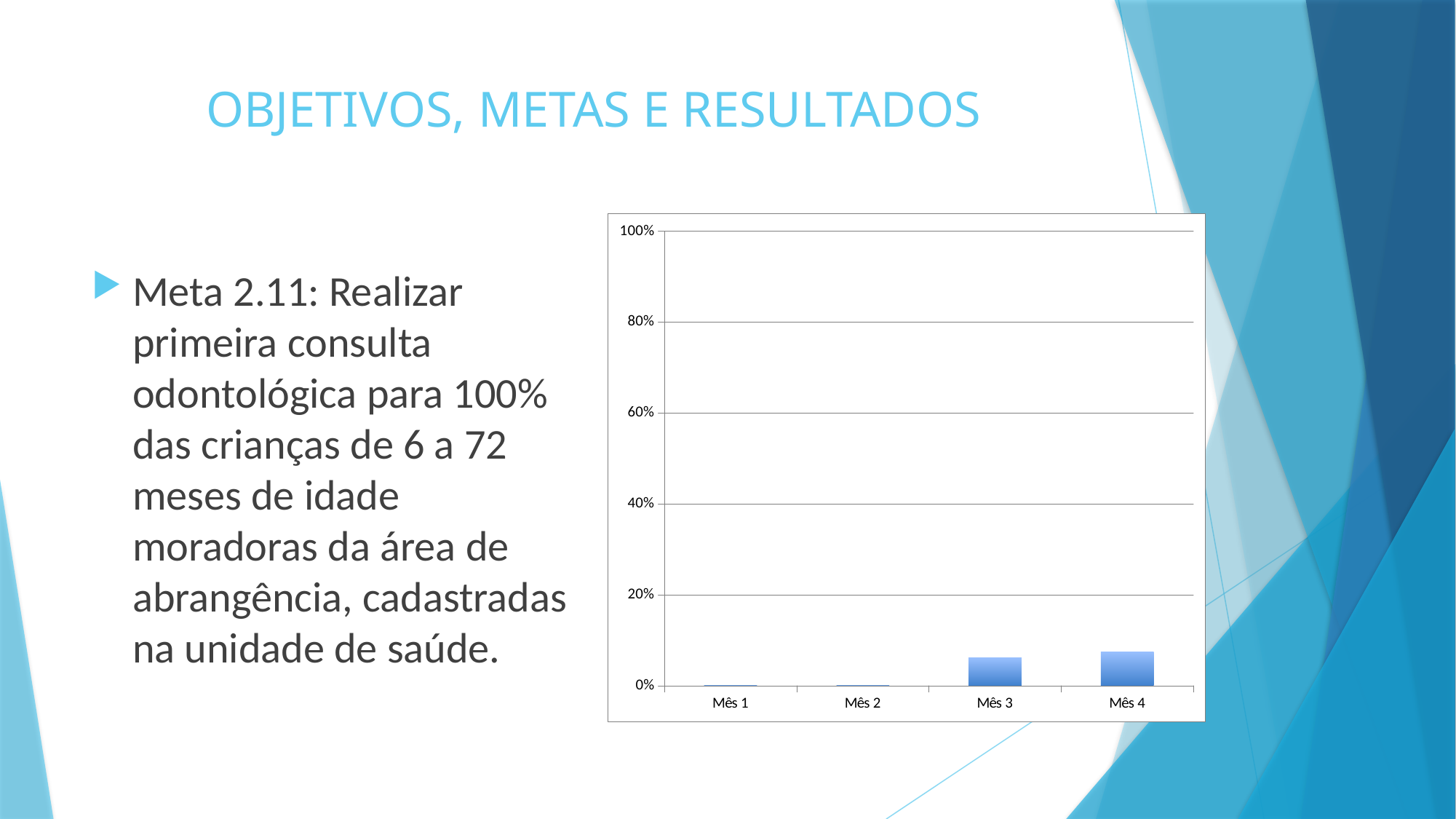
Which is larger, the value for Mês 1 or the value for Mês 4? Mês 4 What is the label of the first category on the x axis? Mês 1 What is the highest value shown on the y axis of the chart? 100% Is the value for Mês 3 greater or less than 20%? less What kind of chart is shown on the slide? bar chart How many categories are shown on the x axis of the chart? 4 Is the value for Mês 4 greater or less than 40%? less Which is larger, the value for Mês 2 or the value for Mês 3? Mês 3 Is the value for Mês 4 greater or less than 20%? less Do the values rise or fall from Mês 1 to Mês 4? rise